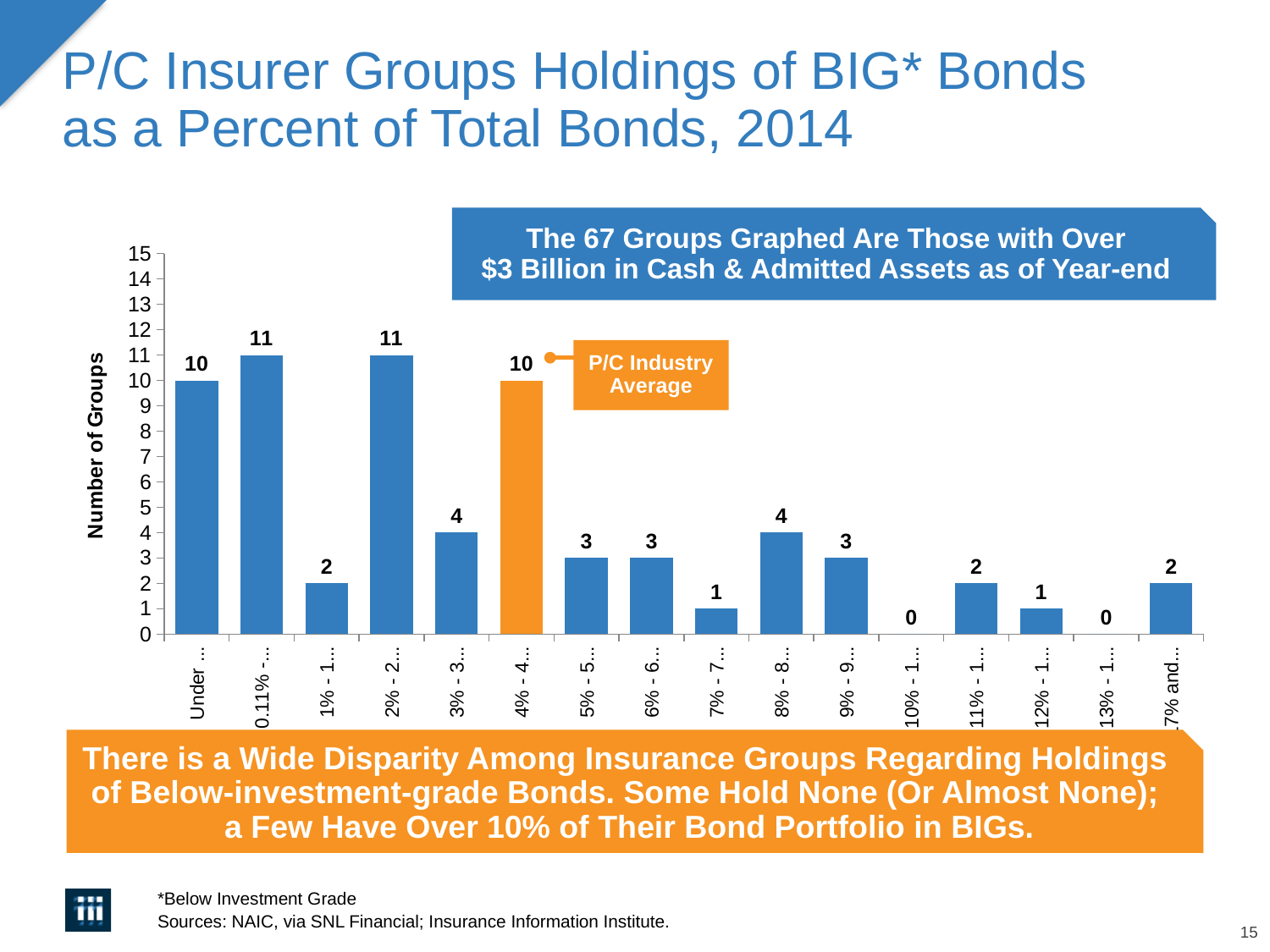
What is the value of the last bar on the right (the '17% and...' category)? 2 What is the value of the orange bar labeled as the P/C Industry Average? 10 How many bars (categories) are plotted in the chart? 16 What is the difference between the orange bar's value and the value of the bar immediately to its right? 7 Which is larger: the value of the first bar on the left or the value of the third bar from the left? the first bar What is the title of the vertical axis? Number of Groups What type of chart is shown on the slide? bar chart What does the orange bar in the chart represent, according to the callout? P/C Industry Average What is the lowest value shown by any bar in the chart? 0 Is the value of the fifth bar from the left greater or less than 5? less What is the value of the first bar on the left (the 'Under ...' category)? 10 What is the highest value shown by any bar in the chart? 11